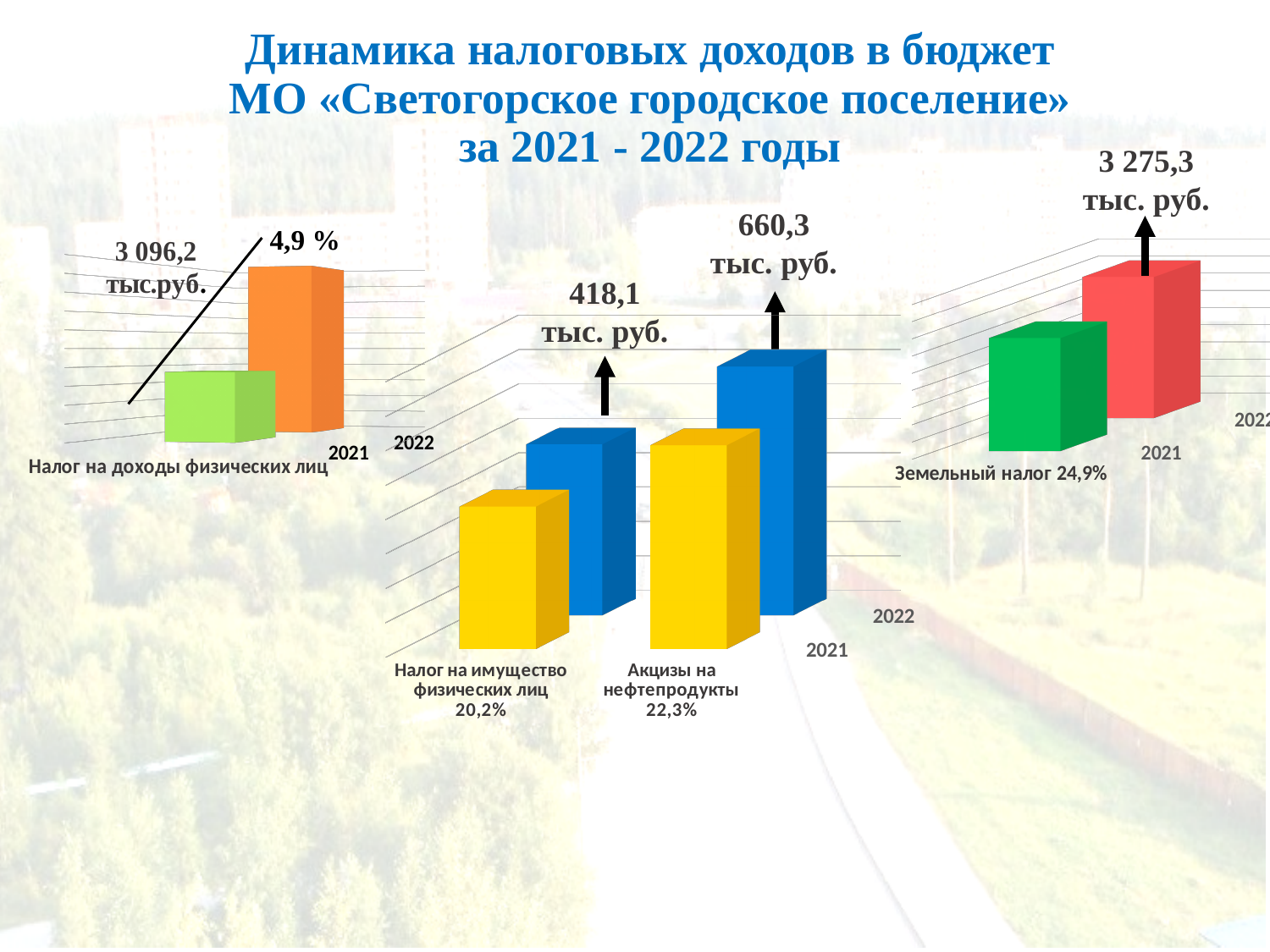
What amount in тыс. руб. is printed above the 2022 bar in the right chart ('Земельный налог')? 3 275,3 тыс. руб. What kind of chart is used for the 'Налог на доходы физических лиц' chart on the left of the slide? bar chart In the middle chart, for 'Акцизы на нефтепродукты', which year has the larger value, 2021 or 2022? 2022 In the right chart ('Земельный налог 24,9%'), which year has the taller bar, 2021 or 2022? 2022 What kind of chart is the right chart ('Земельный налог 24,9%')? bar chart In the left chart ('Налог на доходы физических лиц'), does the value rise or fall from 2021 to 2022? rise In the middle chart, for 'Налог на имущество физических лиц', does the value rise or fall from 2021 to 2022? rise In the left chart ('Налог на доходы физических лиц'), which year has the taller bar, 2021 or 2022? 2022 What percentage is printed next to the category label 'Земельный налог' in the right chart? 24,9% How many years (series) are compared in the right chart ('Земельный налог')? 2 How many categories are shown in the middle chart (the one with 'Налог на имущество физических лиц' and 'Акцизы на нефтепродукты')? 2